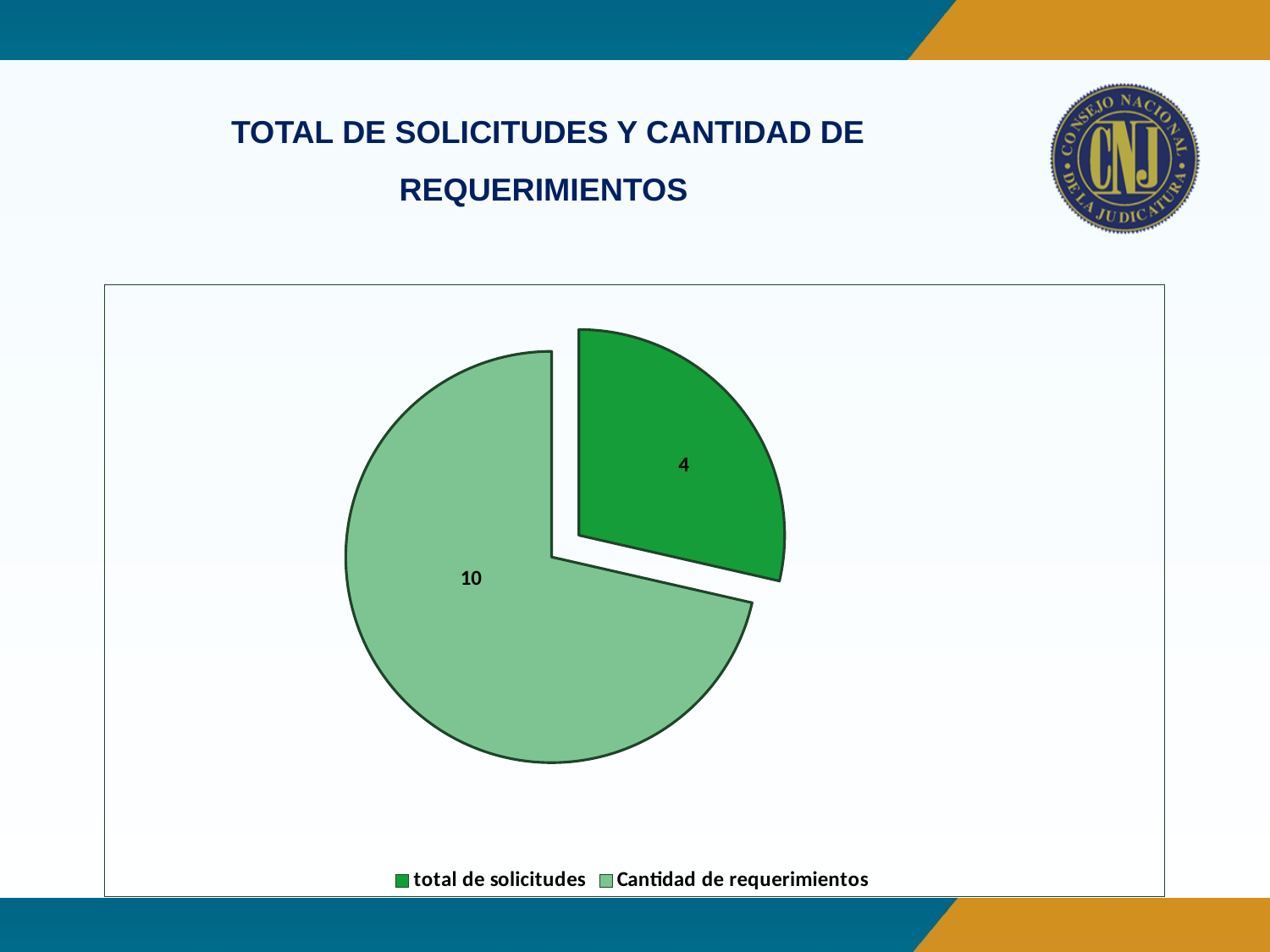
Which slice is the largest? Cantidad de requerimientos How many entries does the legend list? 2 What is the value for 'Cantidad de requerimientos'? 10 Which slice is pulled out (exploded) from the pie? total de solicitudes What is the value for 'total de solicitudes'? 4 How many slices does the pie chart have? 2 What is the total of all slices in the pie chart? 14 What is the title of the slide above the chart? TOTAL DE SOLICITUDES Y CANTIDAD DE REQUERIMIENTOS What type of chart is shown on the slide? pie chart Which is larger, 'total de solicitudes' or 'Cantidad de requerimientos'? Cantidad de requerimientos What is the difference between 'Cantidad de requerimientos' and 'total de solicitudes'? 6 Which slice is the smallest? total de solicitudes